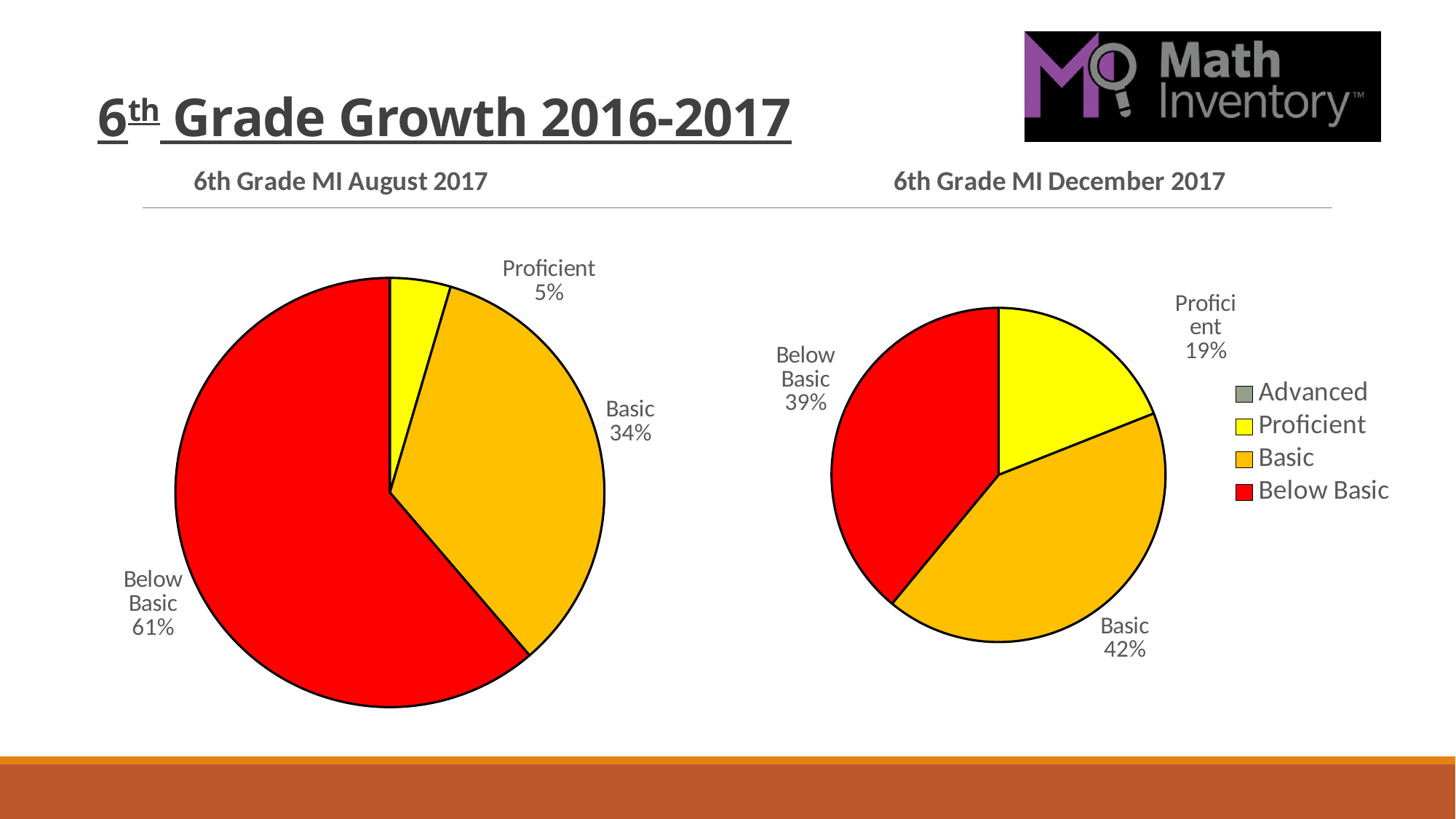
In the '6th Grade MI December 2017' chart, which category has the largest share? Basic What colour represents Below Basic in the charts? Red What type of chart is used on this slide? Pie chart What is the difference between the Below Basic share in the August 2017 chart and the Below Basic share in the December 2017 chart? 22% In the '6th Grade MI August 2017' chart, what percentage is Below Basic? 61% In the '6th Grade MI December 2017' chart, what percentage is Basic? 42% In the '6th Grade MI August 2017' chart, what percentage is Proficient? 5% How many categories does the legend list? 4 In the '6th Grade MI August 2017' chart, which category has the largest share? Below Basic In the '6th Grade MI August 2017' chart, which is larger, Basic or Proficient? Basic In the '6th Grade MI December 2017' chart, what percentage is Below Basic? 39%